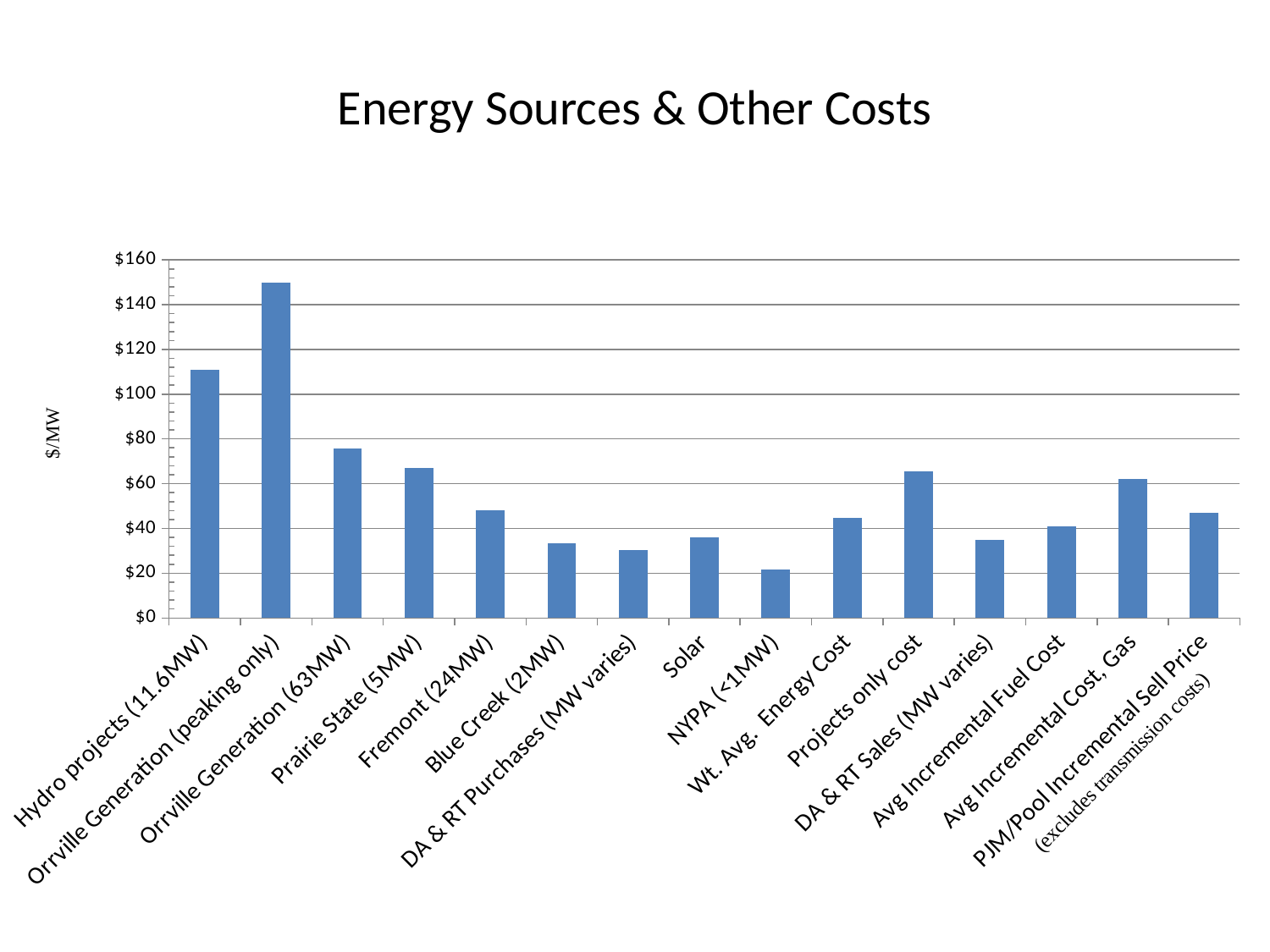
What kind of chart is shown on the slide? bar chart Which is larger, the value for Projects only cost or the value for Wt. Avg. Energy Cost? Projects only cost How many categories are plotted on the chart? 15 Which category has the lowest value? NYPA (<1MW) Is the value for Blue Creek (2MW) greater or less than $40? less Is the value for Fremont (24MW) greater or less than $60? less What is the label on the vertical axis of the chart? $/MW Is the value for Hydro projects (11.6MW) greater or less than $100? greater Which is larger, the value for Hydro projects (11.6MW) or the value for Orrville Generation (63MW)? Hydro projects (11.6MW) What is the title of the chart? Energy Sources & Other Costs Which category has the highest value? Orrville Generation (peaking only)